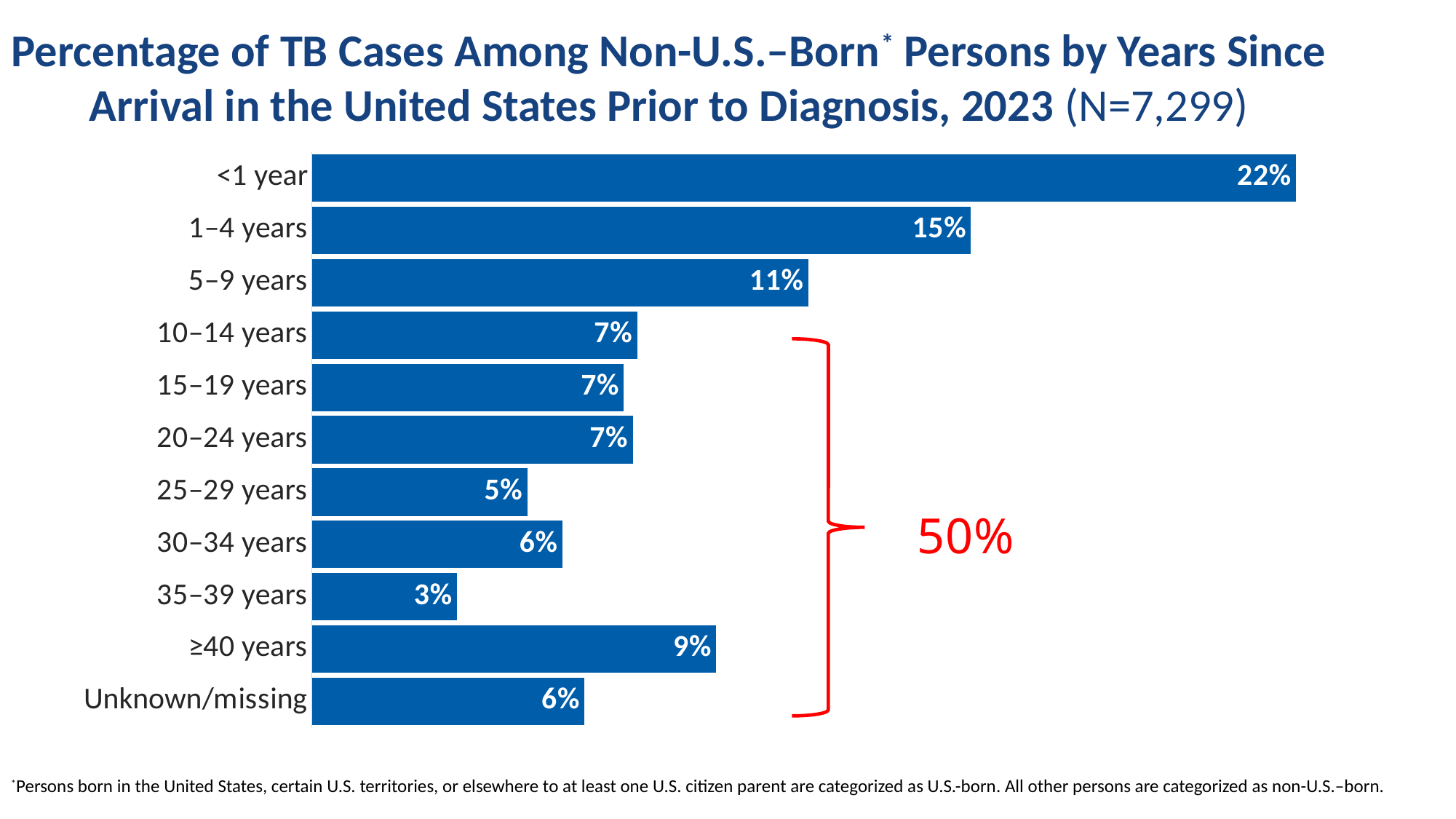
What percentage of TB cases among non-U.S.-born persons had arrived less than 1 year prior to diagnosis? 22% Which category has the highest percentage of TB cases? <1 year What is the value for the 5–9 years category? 11% What kind of chart is shown on the slide? Bar chart How many categories are shown in the chart? 11 What is the difference between the <1 year and 1–4 years values? 7% What is the value for the Unknown/missing category? 6% What percentage does the red bracket annotation indicate for the grouped categories from 10–14 years through Unknown/missing? 50% Which category has the lowest percentage of TB cases? 35–39 years What is the total number of cases (N) stated in the chart title? 7,299 What is the value for the ≥40 years category? 9% Which is larger, the value for 25–29 years or the value for 30–34 years? 30–34 years